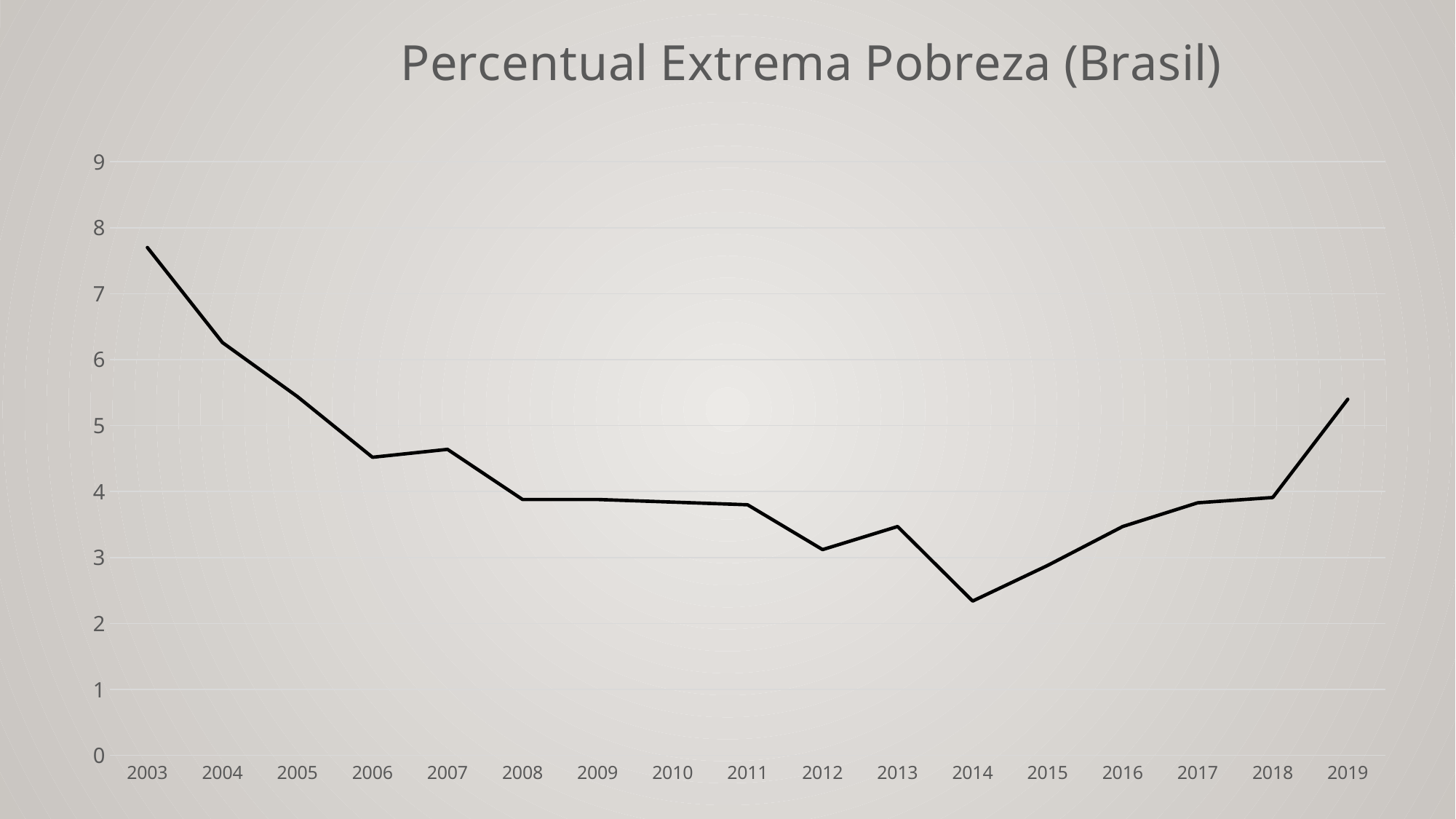
Which year has the highest value? 2003 Which year has the larger value, 2004 or 2006? 2004 Is the value for 2019 greater or less than 5? greater Do the values rise or fall from 2003 to 2014? fall What kind of chart is shown on the slide? line chart Is the value for 2003 greater or less than 7? greater Which year has the larger value, 2019 or 2016? 2019 Is the value for 2014 greater or less than 3? less Which year has the lowest value? 2014 How many years are plotted along the x axis? 17 What is the title of the chart? Percentual Extrema Pobreza (Brasil)